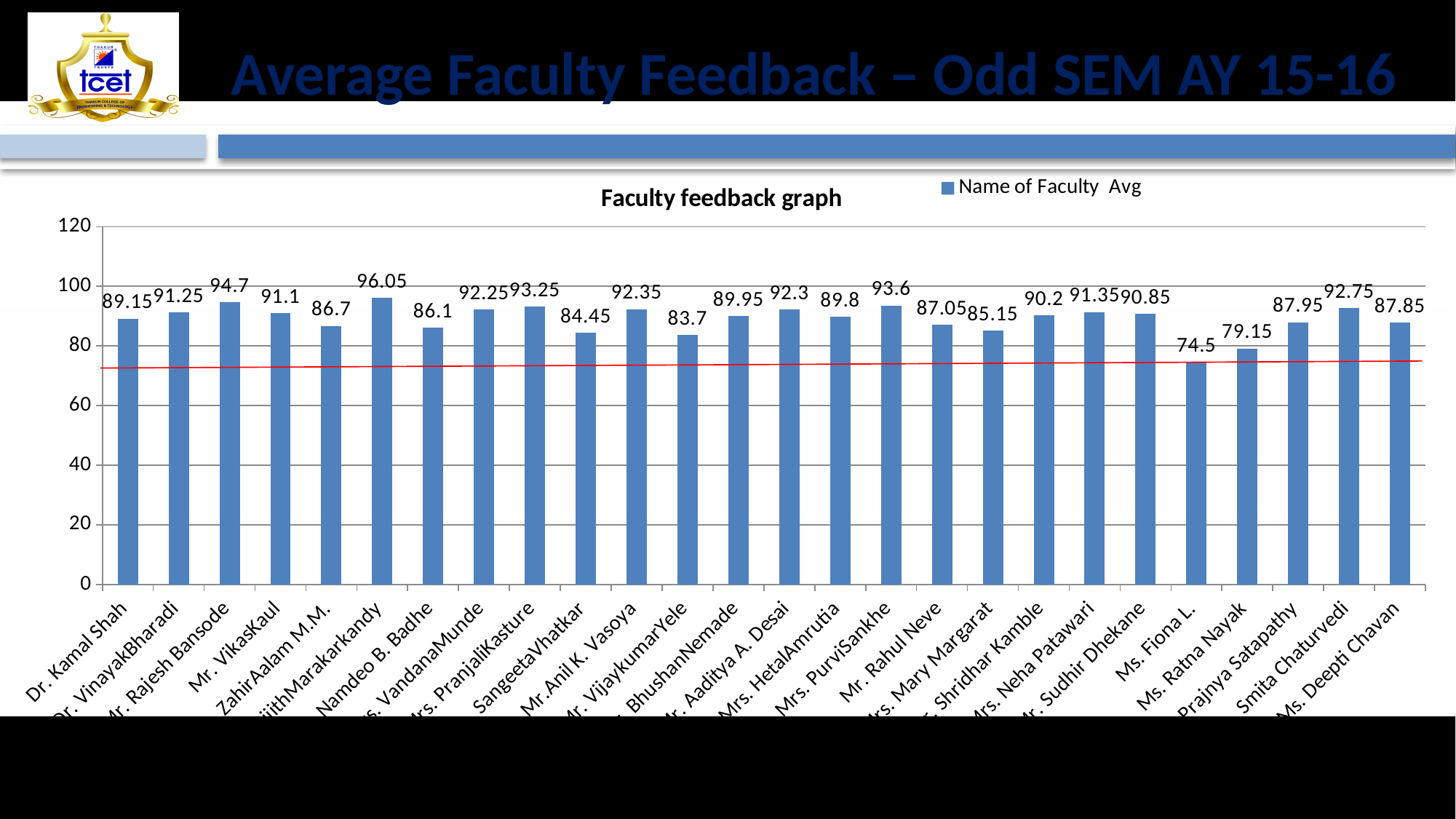
What is the difference between the average feedback values of Mr. Rajesh Bansode and Ms. Fiona L.? 20.2 Is the average feedback value for Ms. Fiona L. greater or less than 80? less Who has the higher average feedback value, Mr. VijaykumarYele or Mr. Aaditya A. Desai? Mr. Aaditya A. Desai Which faculty member has the lowest average feedback value? Ms. Fiona L. What is the average feedback value for Mrs. PurviSankhe? 93.6 What is the title of the chart? Faculty feedback graph What is the average feedback value for Ms. Ratna Nayak? 79.15 How many faculty members are shown in the chart? 26 What is the average feedback value for Dr. Kamal Shah? 89.15 What is the average feedback value for Mr. Rajesh Bansode? 94.7 What kind of chart is shown on the slide? Bar chart How many series does the legend list? 1